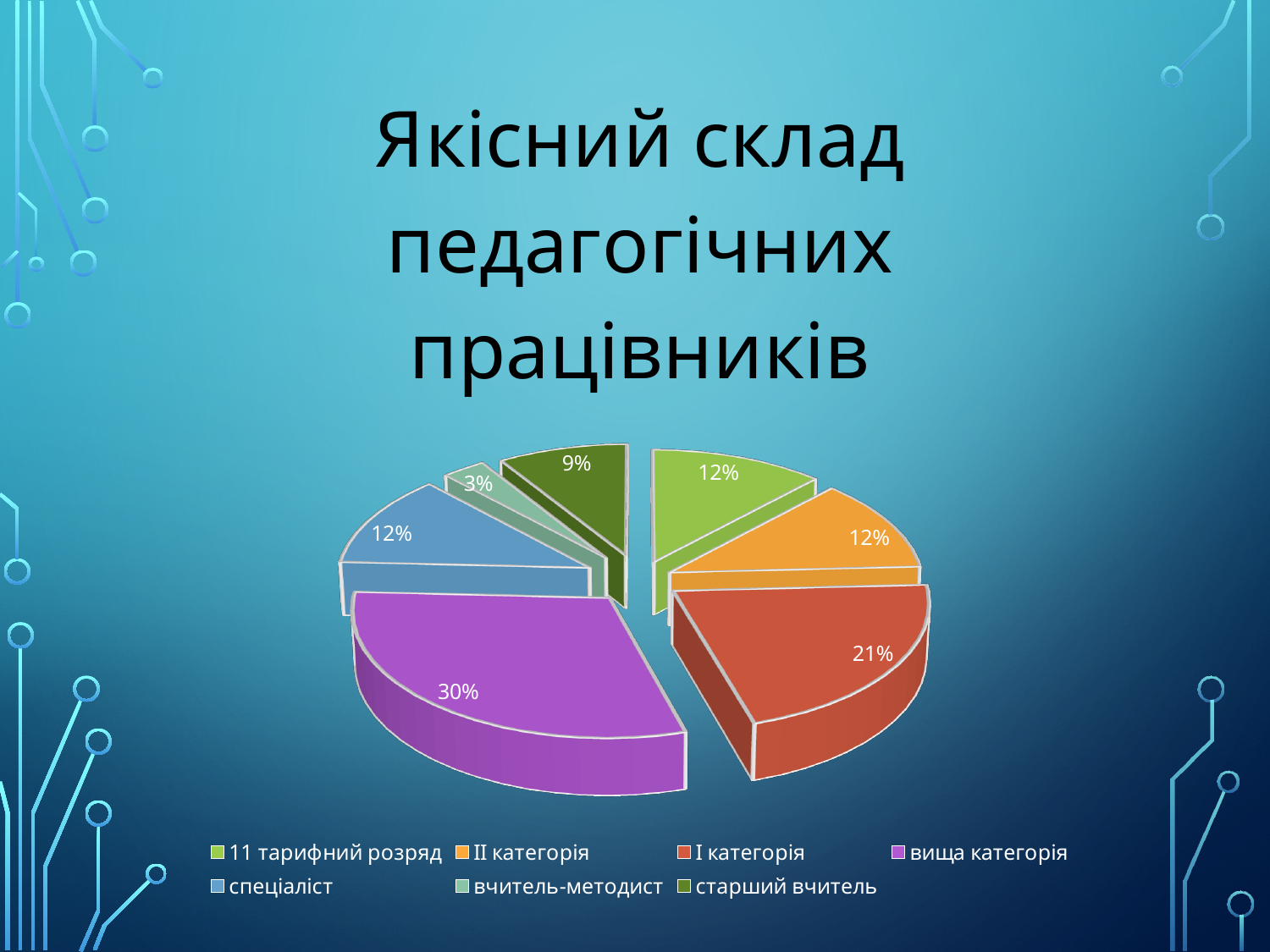
What is the difference in percentage points between вища категорія and І категорія? 9 What share of the pie does вчитель-методист hold? 3% Which category has the smallest slice of the pie? вчитель-методист What share of the pie does І категорія hold? 21% What is the title of the slide? Якісний склад педагогічних працівників How many slices does the pie chart have? 7 Which is larger, the slice for старший вчитель or the slice for вчитель-методист? старший вчитель What kind of chart is shown on the slide? pie chart What share of the pie does вища категорія hold? 30% What colour is the slice for вища категорія? purple Which category has the largest slice of the pie? вища категорія